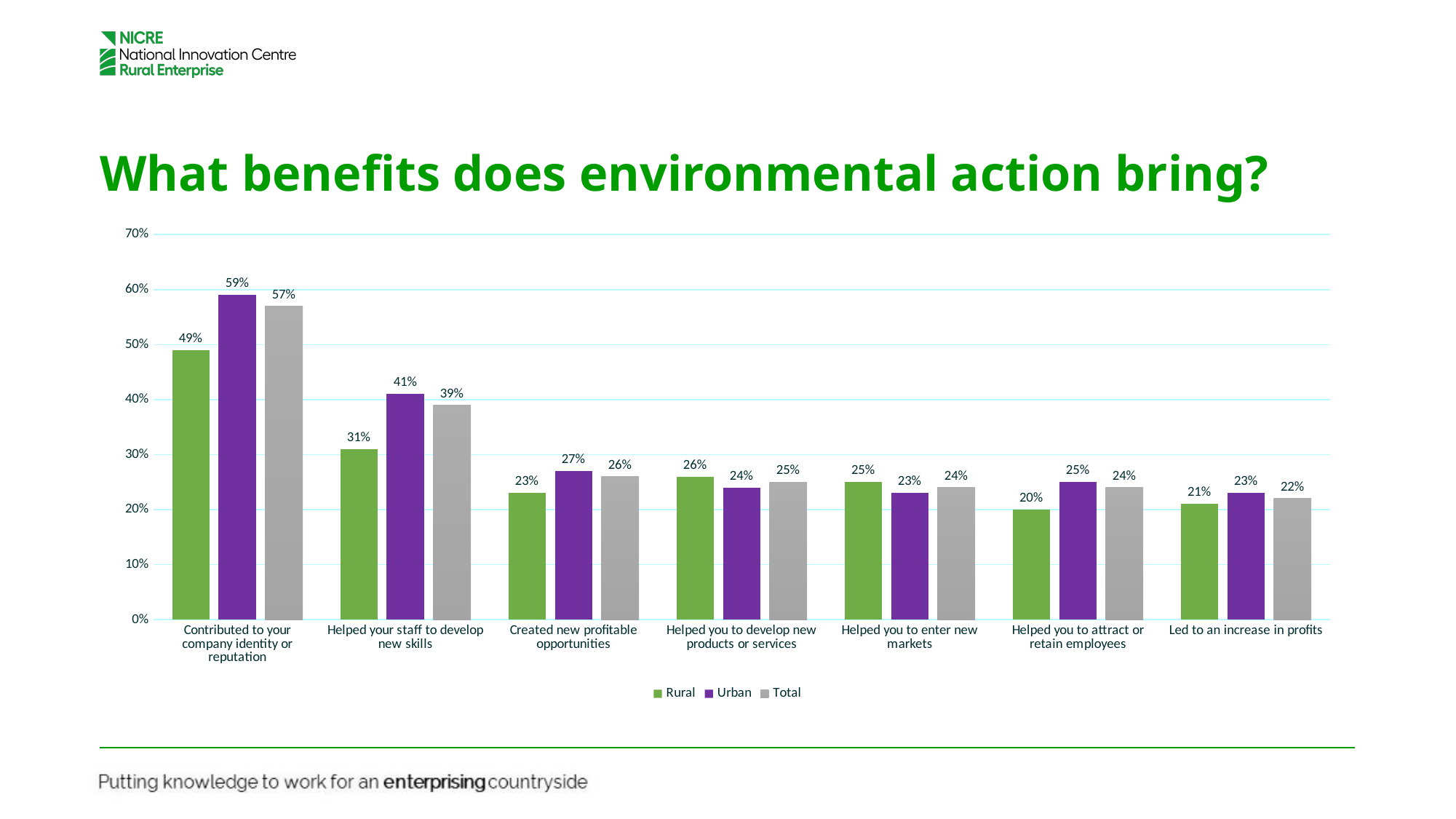
What is the Urban value for 'Helped your staff to develop new skills'? 41% How many categories are shown on the x axis? 7 How many series does the legend list? 3 Which category has the highest Urban value? Contributed to your company identity or reputation What is the Total value for 'Led to an increase in profits'? 22% What is the Rural value for 'Contributed to your company identity or reputation'? 49% What is the difference between the Urban and Rural values for 'Contributed to your company identity or reputation'? 10% Which is larger for 'Helped you to enter new markets': the Rural value or the Urban value? Rural What kind of chart is shown on the slide? Bar chart Is the Total value for 'Helped your staff to develop new skills' greater or less than 30%? greater Which category has the lowest Rural value? Helped you to attract or retain employees What colour are the Urban bars? Purple